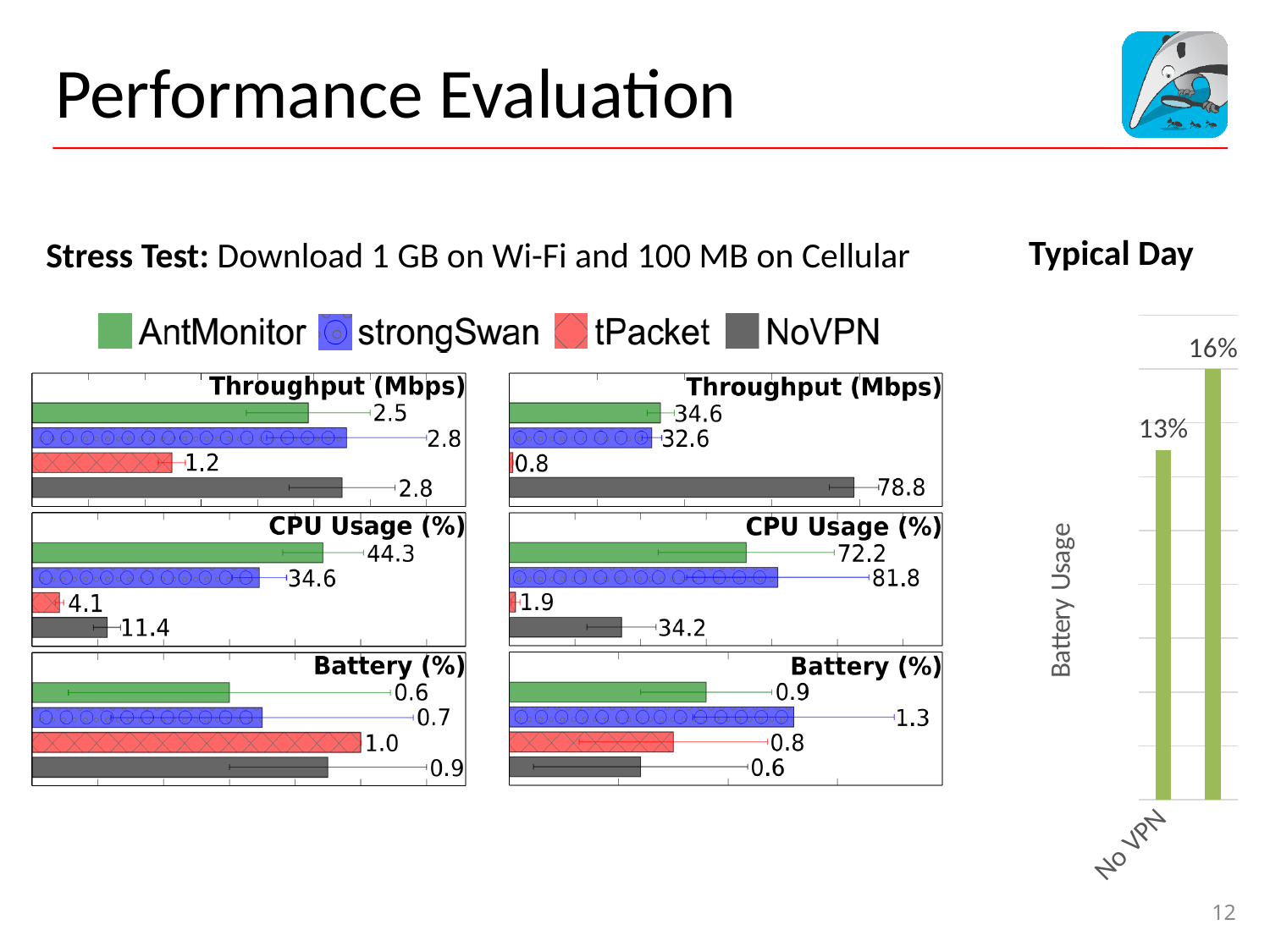
In the right Throughput (Mbps) chart, which series has the lowest throughput? tPacket How many series does the legend above the stress test charts list? 4 In the left CPU Usage (%) chart, what is the value for NoVPN? 11.4 In the right CPU Usage (%) chart, what is the difference between strongSwan and NoVPN? 47.6 In the Typical Day chart, what is the Battery Usage value for No VPN? 13% In the Typical Day chart, what is the highest Battery Usage value shown? 16% In the left Throughput (Mbps) chart, what is the value for tPacket? 1.2 In the left Battery (%) chart, which is larger, the value for tPacket or the value for AntMonitor? tPacket What kind of chart is the Typical Day chart? bar chart In the right Throughput (Mbps) chart, what is the value for NoVPN? 78.8 In the left CPU Usage (%) chart, which series has the highest CPU usage? AntMonitor In the right Battery (%) chart, what is the value for strongSwan? 1.3